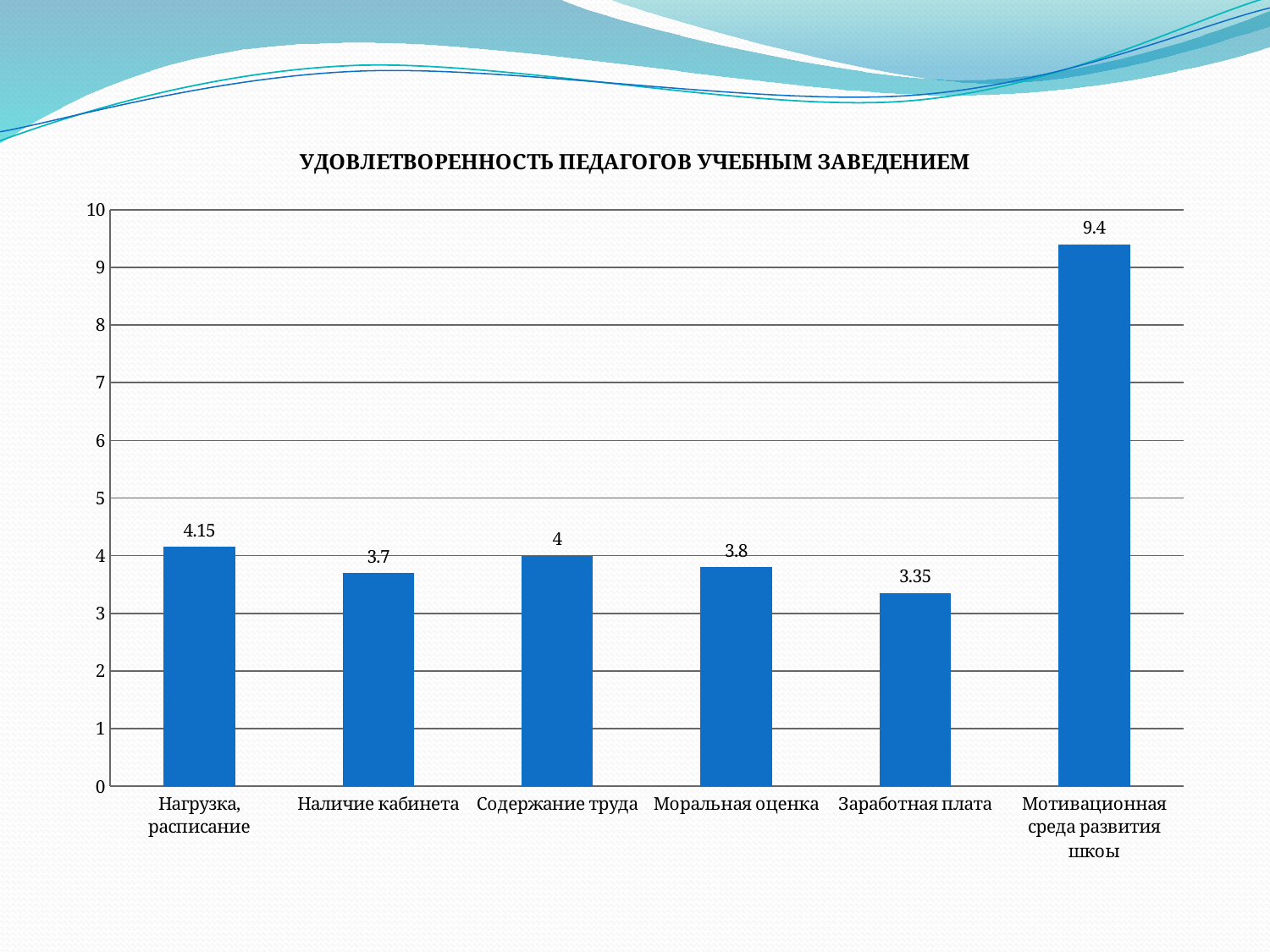
What is the value for Нагрузка, расписание? 4.15 What is the title of the chart? УДОВЛЕТВОРЕННОСТЬ ПЕДАГОГОВ УЧЕБНЫМ ЗАВЕДЕНИЕМ Which category has the highest value? Мотивационная среда развития шкоы Which is larger, the value for Нагрузка, расписание or the value for Наличие кабинета? Нагрузка, расписание What is the value for Наличие кабинета? 3.7 What is the difference between the values for Мотивационная среда развития шкоы and Заработная плата? 6.05 What is the value for Мотивационная среда развития шкоы? 9.4 How many categories are shown on the chart? 6 Which category has the lowest value? Заработная плата What is the value for Заработная плата? 3.35 What kind of chart is shown on the slide? Bar chart What is the difference between the values for Содержание труда and Моральная оценка? 0.2